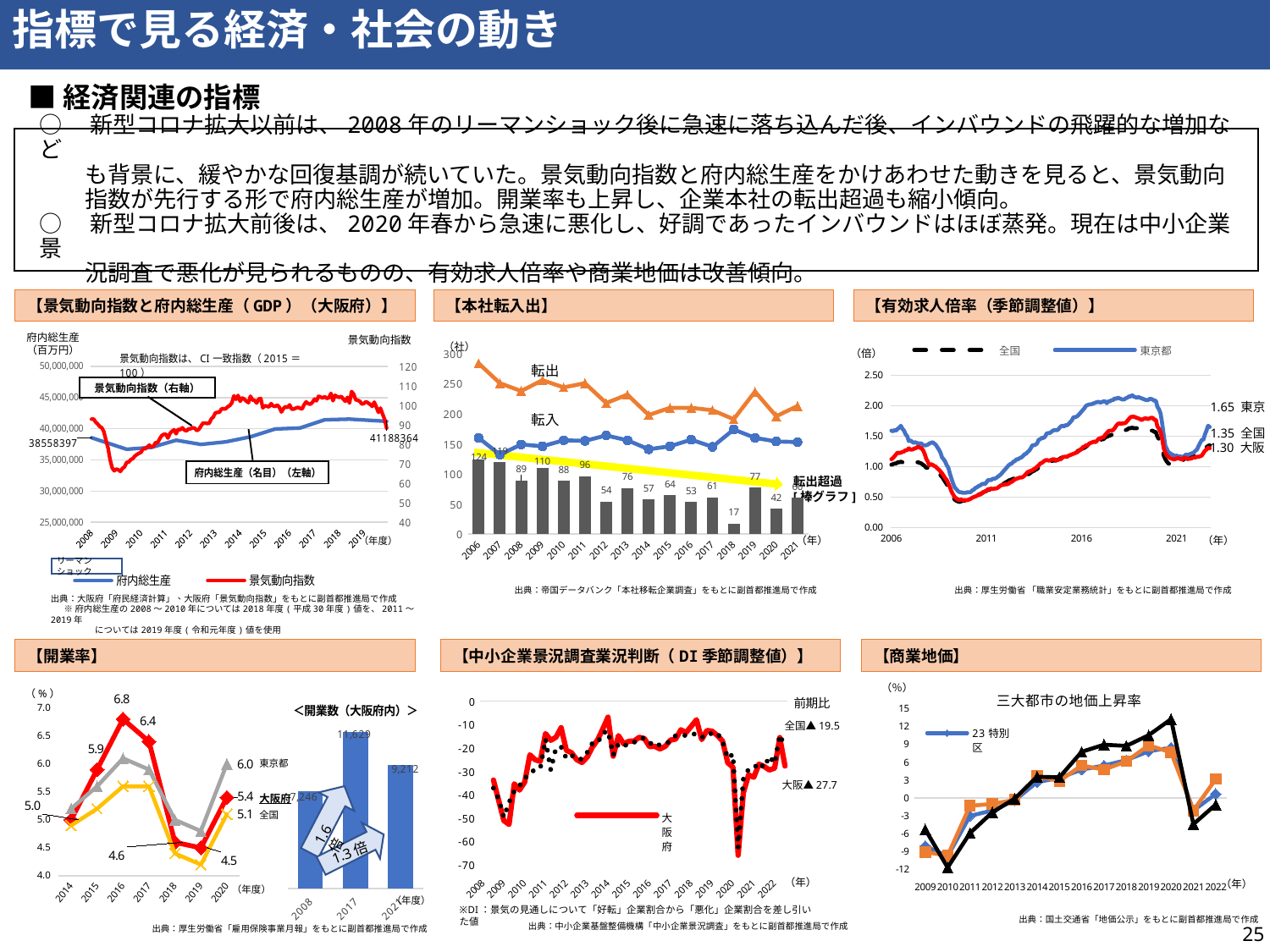
In the 【中小企業景況調査業況判断（DI季節調整値）】 chart, what is the latest value shown for 大阪? ▲27.7 In the 【開業率】 chart, what is the 大阪府 value for 2016? 6.8 In the 開業数（大阪府内） bar chart, what is the value for 2017? 11,629 In the 【本社転入出】 chart, which year has the lowest 転出超過 bar? 2018 In the 【景気動向指数と府内総生産（GDP）（大阪府）】 chart, what is the 府内総生産 value labelled for 2019? 41188364 In the 【本社転入出】 chart, what is the difference between the 転出超過 bars for 2019 and 2020? 35 In the 【本社転入出】 chart, which is larger, the 転出超過 bar for 2009 or for 2012? 2009 In the 【有効求人倍率（季節調整値）】 chart, what is the latest value shown for 大阪? 1.30 In the 【有効求人倍率（季節調整値）】 chart, what is the latest value shown for 東京? 1.65 In the 【開業率】 chart, what is the 東京都 value for 2020? 6.0 In the 【本社転入出】 chart, what is the value of the 転出超過 bar for 2006? 124 In the 【本社転入出】 chart, what is the value of the 転出超過 bar for 2018? 17